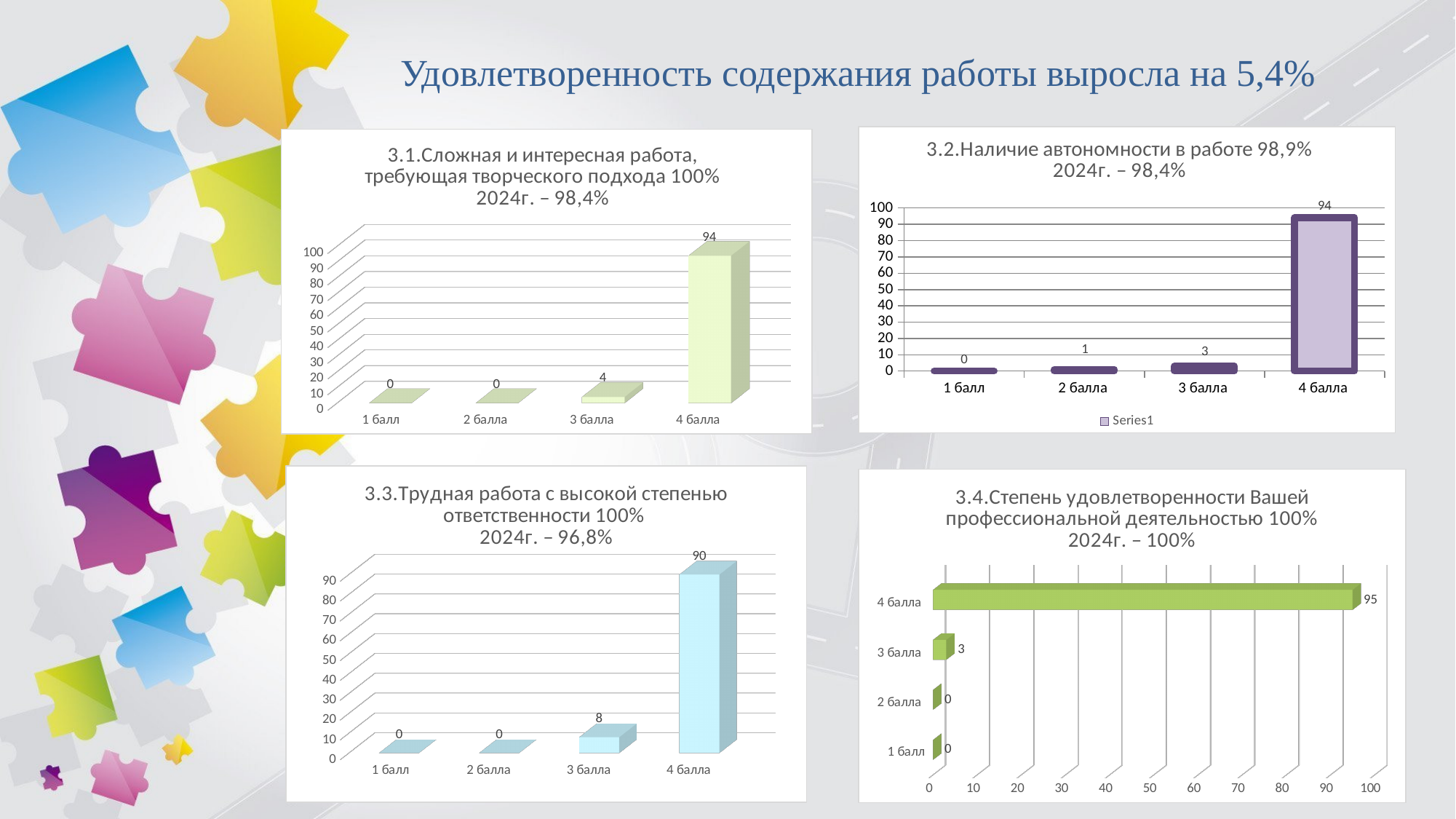
In the chart titled "3.4.Степень удовлетворенности Вашей профессиональной деятельностью", what is the value for 4 балла? 95 In the chart titled "3.2.Наличие автономности в работе", which category has the highest value? 4 балла What legend entry is shown in the chart titled "3.2.Наличие автономности в работе"? Series1 In the chart titled "3.2.Наличие автономности в работе", what is the difference between the values for 4 балла and 3 балла? 91 In the chart titled "3.1.Сложная и интересная работа, требующая творческого подхода", what is the value for 3 балла? 4 In the chart titled "3.4.Степень удовлетворенности Вашей профессиональной деятельностью", which is larger, the value for 3 балла or the value for 2 балла? 3 балла How many categories are shown in the chart titled "3.4.Степень удовлетворенности Вашей профессиональной деятельностью"? 4 What kind of chart is the chart titled "3.4.Степень удовлетворенности Вашей профессиональной деятельностью"? Bar chart In the chart titled "3.1.Сложная и интересная работа, требующая творческого подхода", what is the value for 4 балла? 94 In the chart titled "3.3.Трудная работа с высокой степенью ответственности", what is the value for 3 балла? 8 In the chart titled "3.3.Трудная работа с высокой степенью ответственности", what is the value for 4 балла? 90 In the chart titled "3.2.Наличие автономности в работе", what is the value for 2 балла? 1